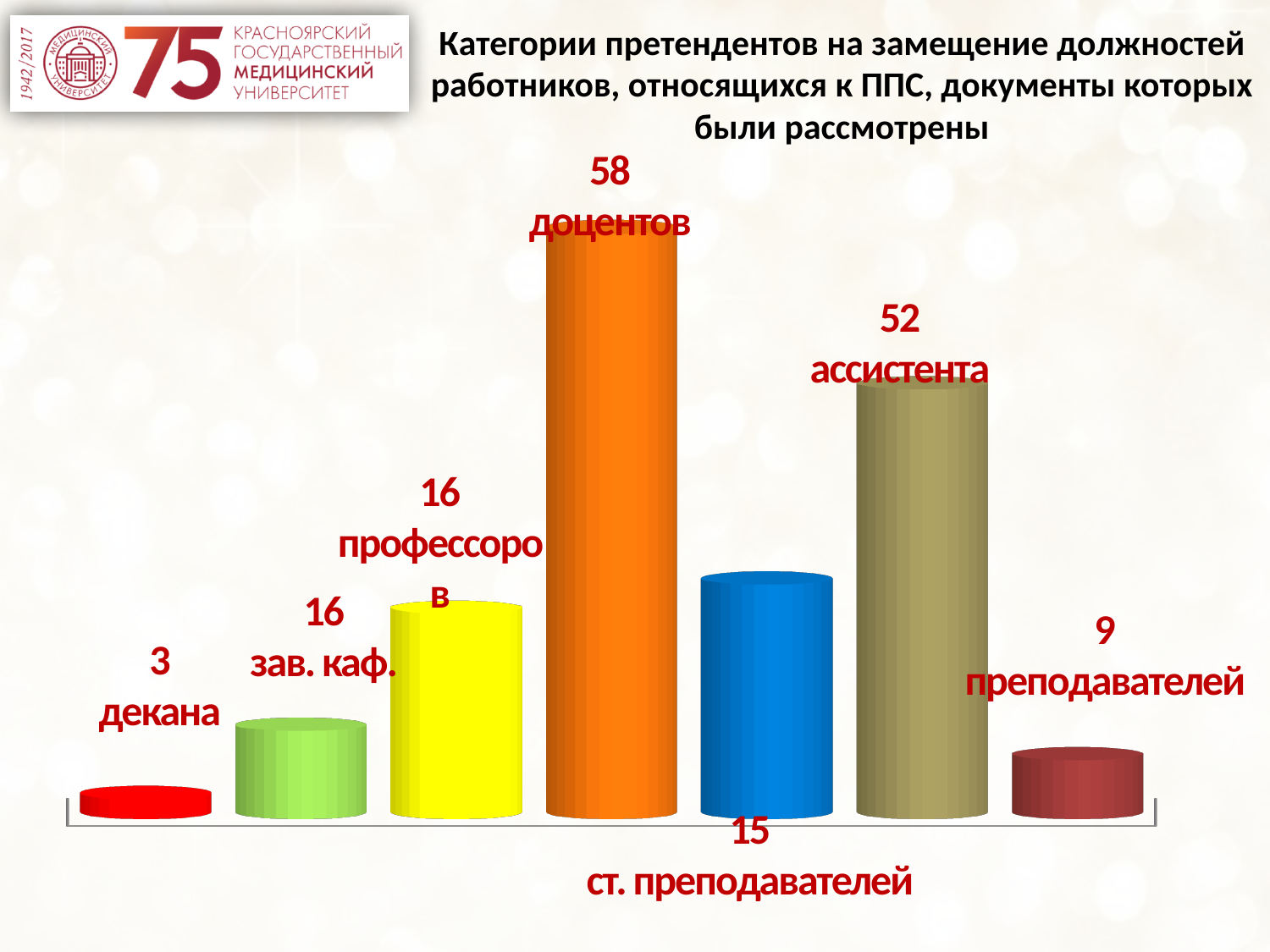
What is the difference between the values for доцентов and ассистента? 6 How many доцентов are shown on the chart? 58 What is the value for декана? 3 What is the value for ст. преподавателей? 15 Which is larger, the value for ассистента or the value for преподавателей? ассистента What is the value for ассистента? 52 How many categories are shown on the chart? 7 Which category has the lowest value? декана Which category has the highest value? доцентов What is the value for преподавателей? 9 What is the difference between the values for зав. каф. and декана? 13 What kind of chart is shown on the slide? bar chart